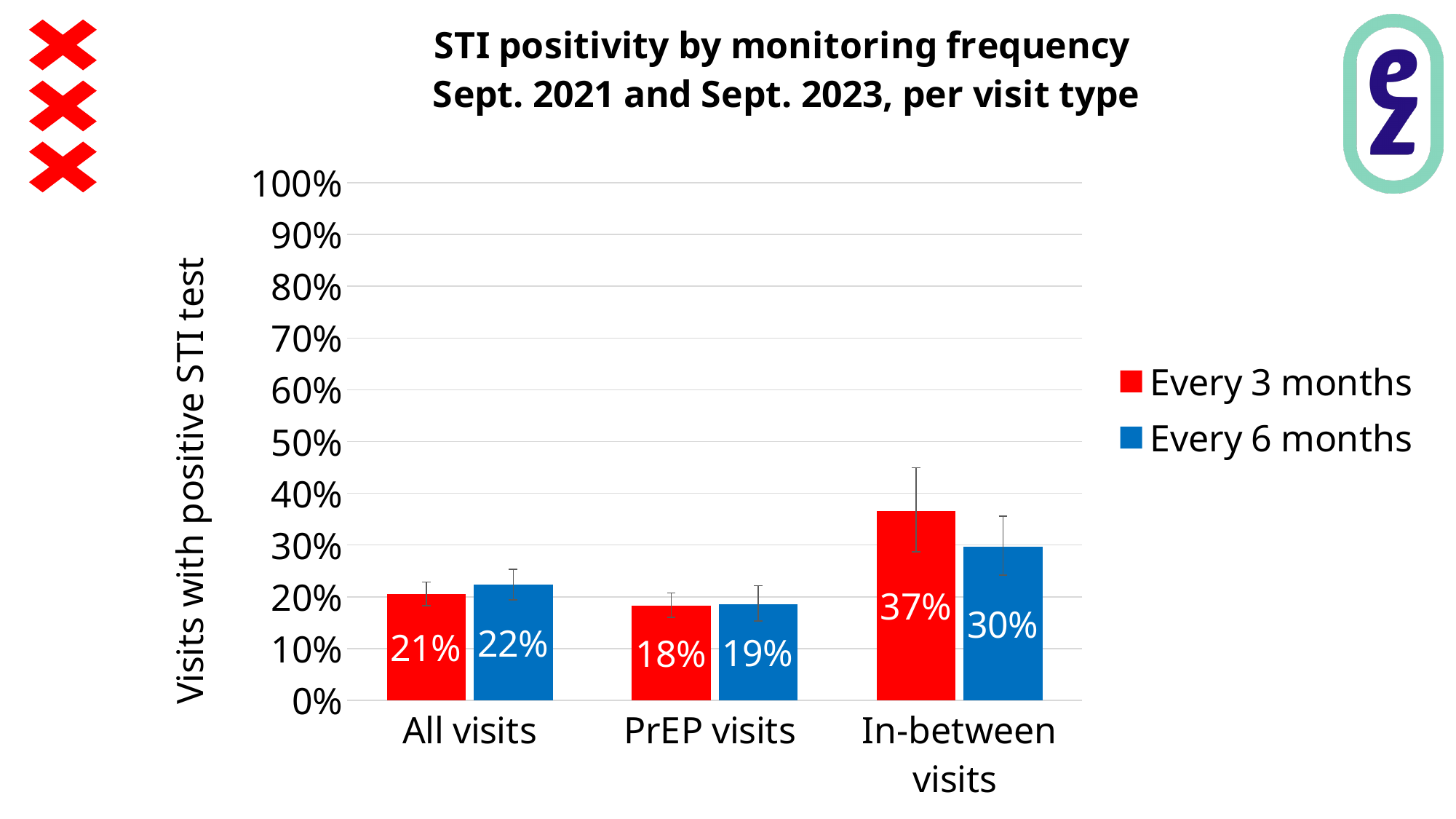
What is the STI positivity for 'Every 3 months' at In-between visits? 37% Which visit type has the lowest STI positivity for 'Every 6 months'? PrEP visits What is the STI positivity for 'Every 6 months' at PrEP visits? 19% What is the STI positivity for 'Every 3 months' at PrEP visits? 18% What is the difference between the 'Every 3 months' and 'Every 6 months' values at In-between visits? 7% At In-between visits, which is larger: 'Every 3 months' or 'Every 6 months'? Every 3 months How many series does the legend list? 2 How many visit types are shown on the x axis? 3 What is the STI positivity for 'Every 6 months' at All visits? 22% Which visit type has the highest STI positivity for 'Every 3 months'? In-between visits What kind of chart is shown on the slide? Bar chart Is the 'Every 3 months' value for In-between visits greater or less than 30%? greater